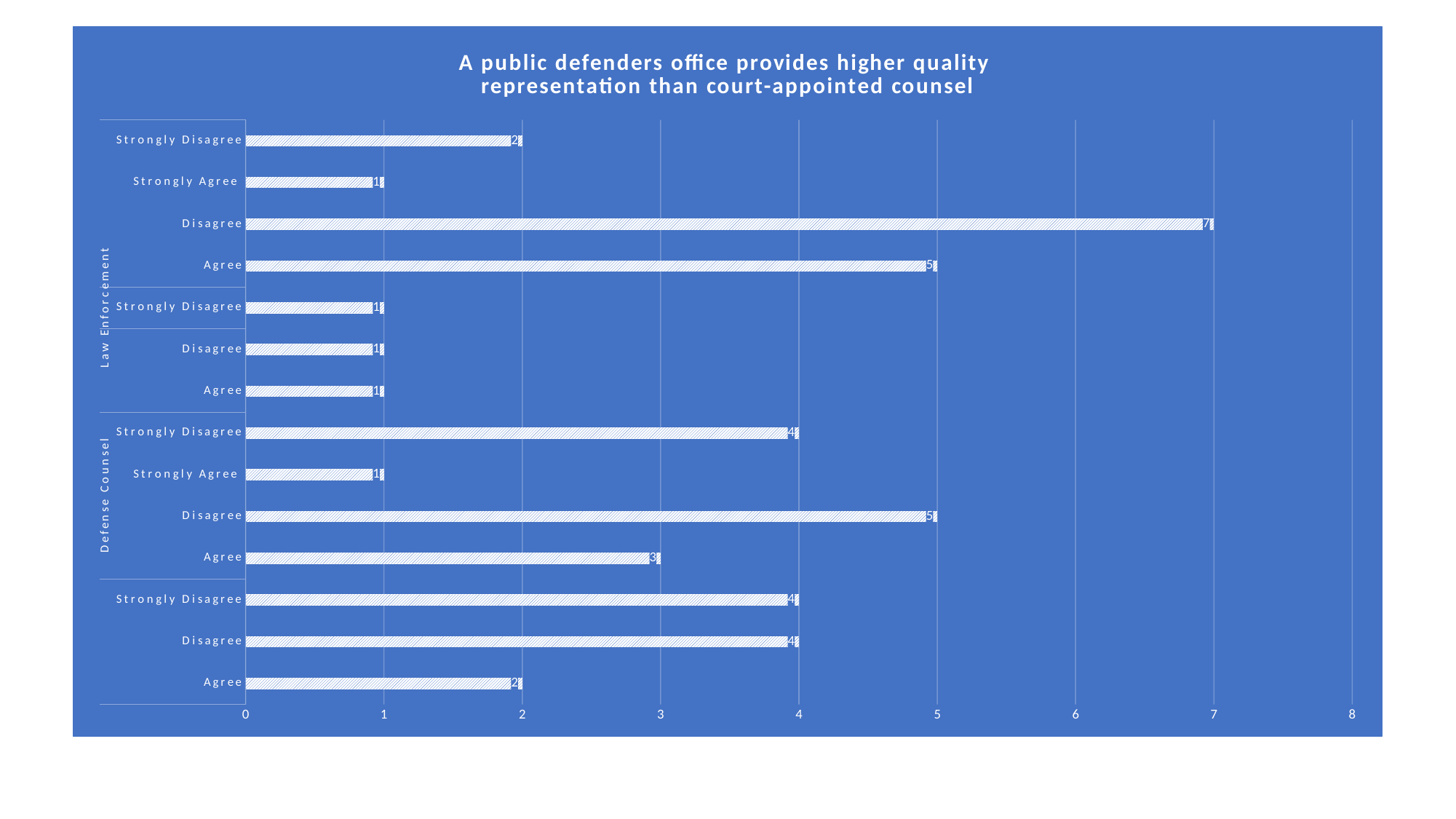
How many bars are plotted in the chart? 14 In the Defense Counsel group, what is the difference between the Disagree and Agree values? 2 In the Defense Counsel group, what is the value for Disagree? 5 In the Defense Counsel group, what is the value for Strongly Agree? 1 What kind of chart is shown on the slide? bar chart What is the highest value shown by any bar in the chart? 7 In the Defense Counsel group, which response has the highest value? Disagree What is the title of the chart? A public defenders office provides higher quality representation than court-appointed counsel In the Defense Counsel group, what is the value for Strongly Disagree? 4 In the Defense Counsel group, which response has the lowest value? Strongly Agree In the Defense Counsel group, what is the value for Agree? 3 In the Defense Counsel group, which is larger: Strongly Disagree or Agree? Strongly Disagree